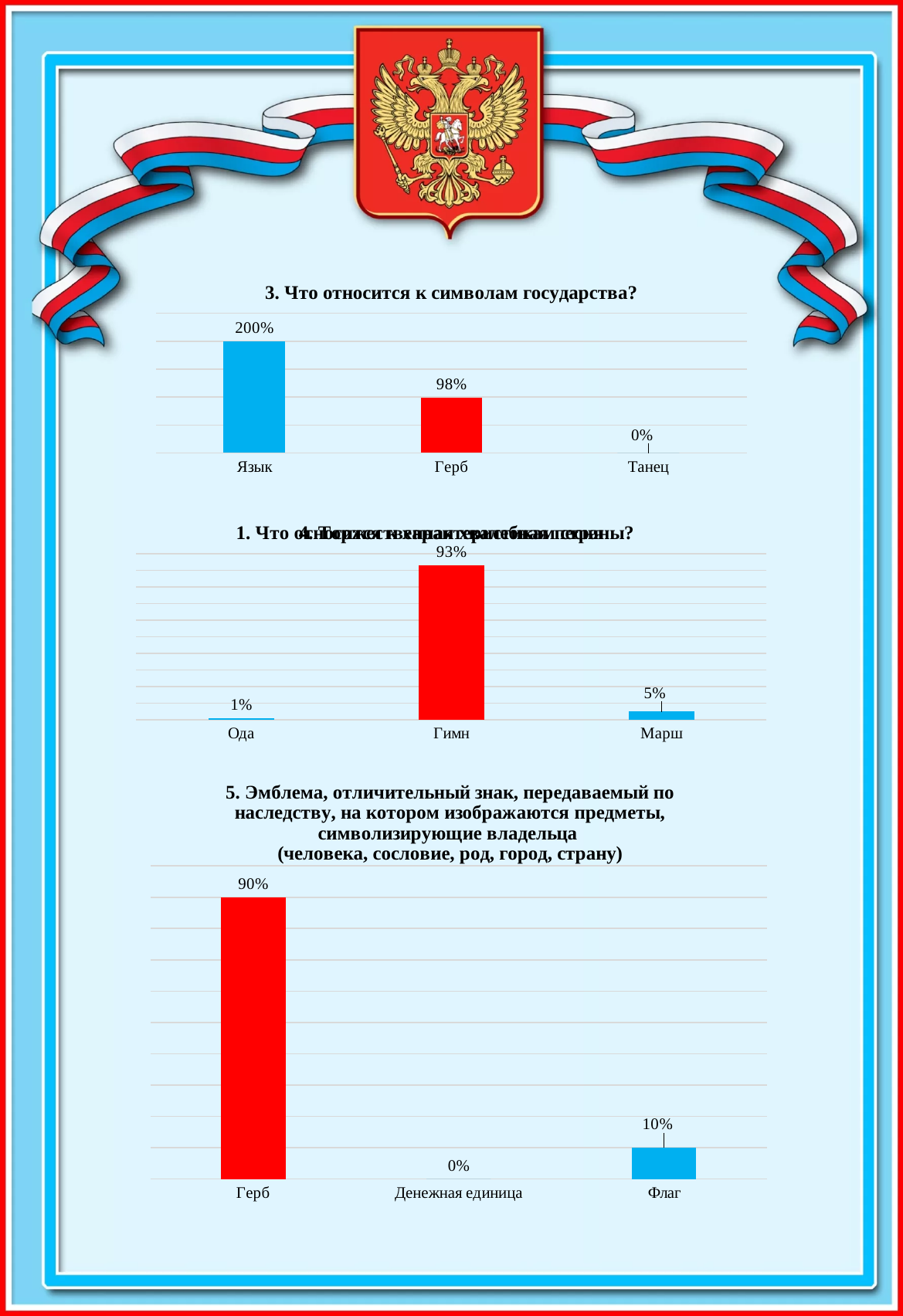
In the middle chart on the slide, what is the value for Марш? 5% In the bottom chart titled "5. Эмблема, отличительный знак...", how many categories are shown on the x axis? 3 In the bottom chart titled "5. Эмблема, отличительный знак...", what is the value for Флаг? 10% In the bottom chart titled "5. Эмблема, отличительный знак...", what is the value for Денежная единица? 0% In the top chart titled "3. Что относится к символам государства?", which category has the lowest value? Танец In the top chart titled "3. Что относится к символам государства?", what is the value for Герб? 98% What type of chart is the bottom chart titled "5. Эмблема, отличительный знак..."? Bar chart In the top chart titled "3. Что относится к символам государства?", what is the value for Язык? 200% In the top chart titled "3. Что относится к символам государства?", what is the difference between the values for Язык and Герб? 102% In the middle chart on the slide, which category has the highest value? Гимн In the middle chart on the slide, what is the value for Гимн? 93% In the middle chart on the slide, which is larger, the value for Ода or the value for Марш? Марш